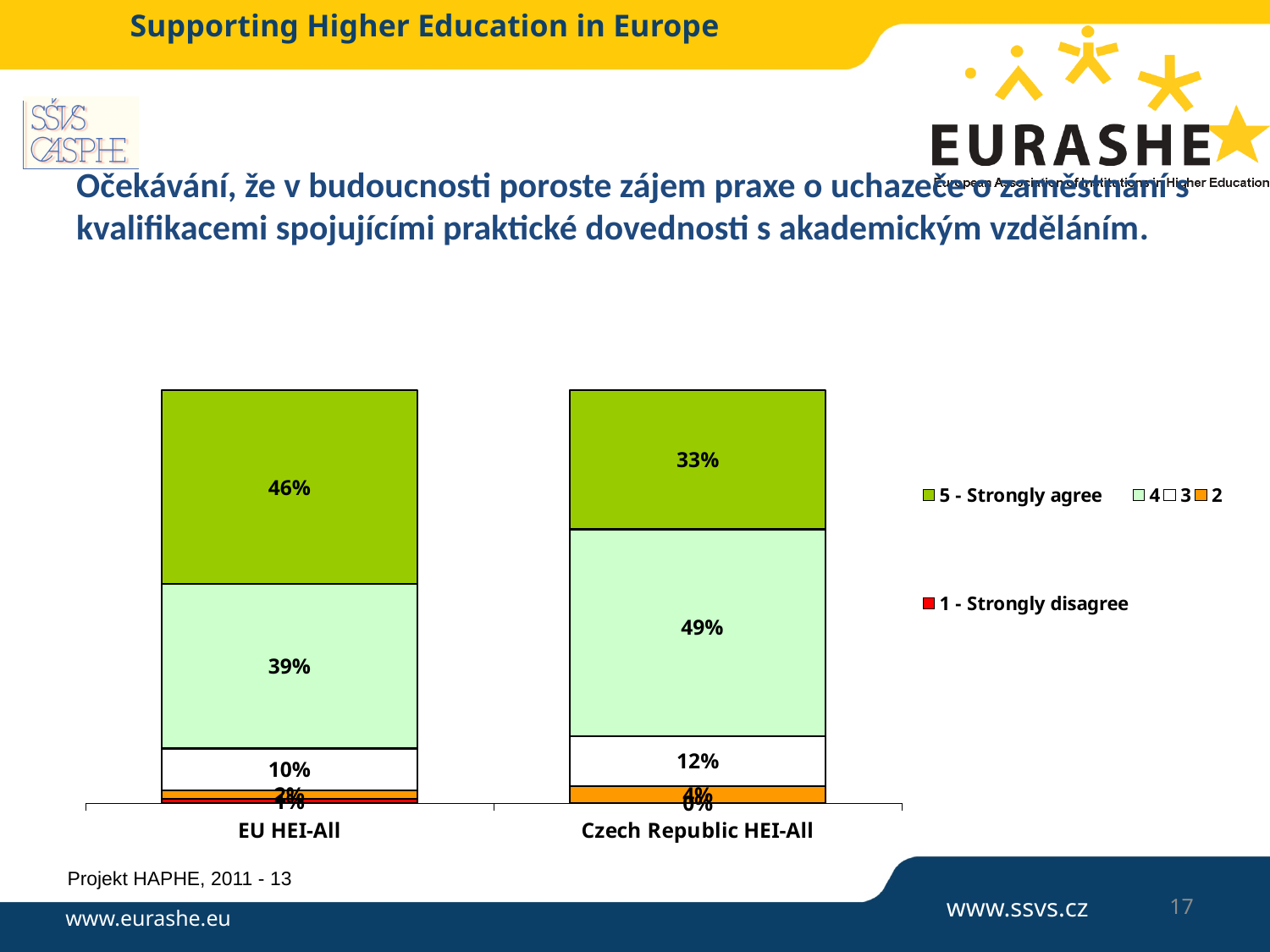
What is the value of series '4' for Czech Republic HEI-All? 49% How many categories are shown on the x axis of the chart? 2 Which category has the larger value for '5 - Strongly agree', EU HEI-All or Czech Republic HEI-All? EU HEI-All What is the value of series '3' for Czech Republic HEI-All? 12% What is the difference between the series '4' values for Czech Republic HEI-All and EU HEI-All? 10% What is the difference between the '5 - Strongly agree' values for EU HEI-All and Czech Republic HEI-All? 13% What is the value of '5 - Strongly agree' for EU HEI-All? 46% Which category label appears on the left of the x axis? EU HEI-All What is the value of series '3' for EU HEI-All? 10% What is the value of '5 - Strongly agree' for Czech Republic HEI-All? 33% What kind of chart is shown on the slide? bar chart How many series does the chart's legend list? 5